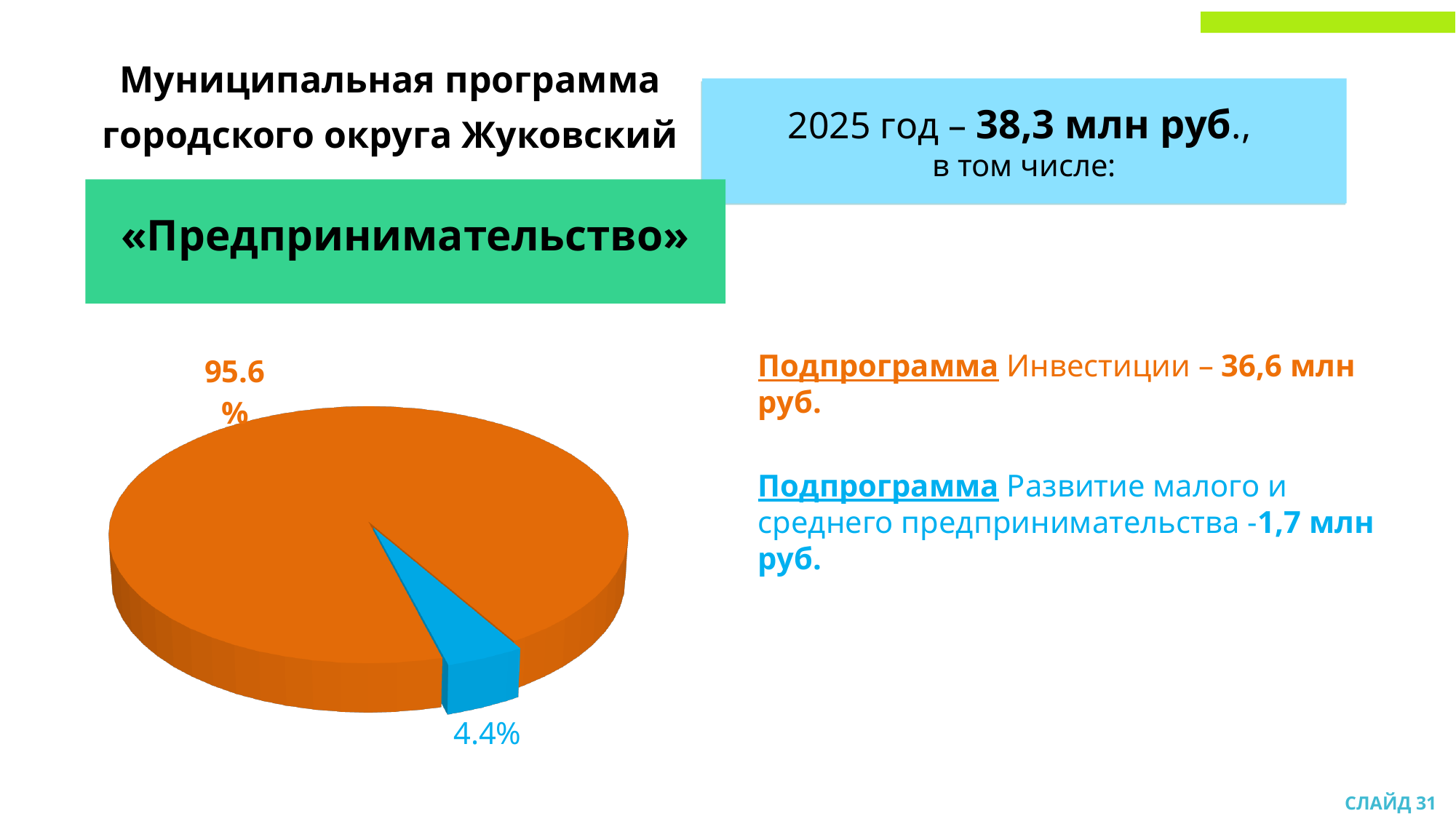
What colour is the slice labelled 95.6% in the pie chart? orange What share of the pie does the blue slice represent? 4.4% Which slice of the pie chart is the largest? the orange slice (95.6%) Which is larger, the orange slice or the blue slice of the pie chart? the orange slice What is the difference in percentage points between the orange slice and the blue slice? 91.2 How many slices does the pie chart have? 2 What percentage is shown for the orange slice of the pie chart? 95.6% What is the total of the two percentages shown on the pie chart? 100% Which slice of the pie chart is the smallest? the blue slice (4.4%) What percentage is shown for the blue slice of the pie chart? 4.4% What kind of chart is shown on the slide? pie chart What colour is the slice labelled 4.4% in the pie chart? blue